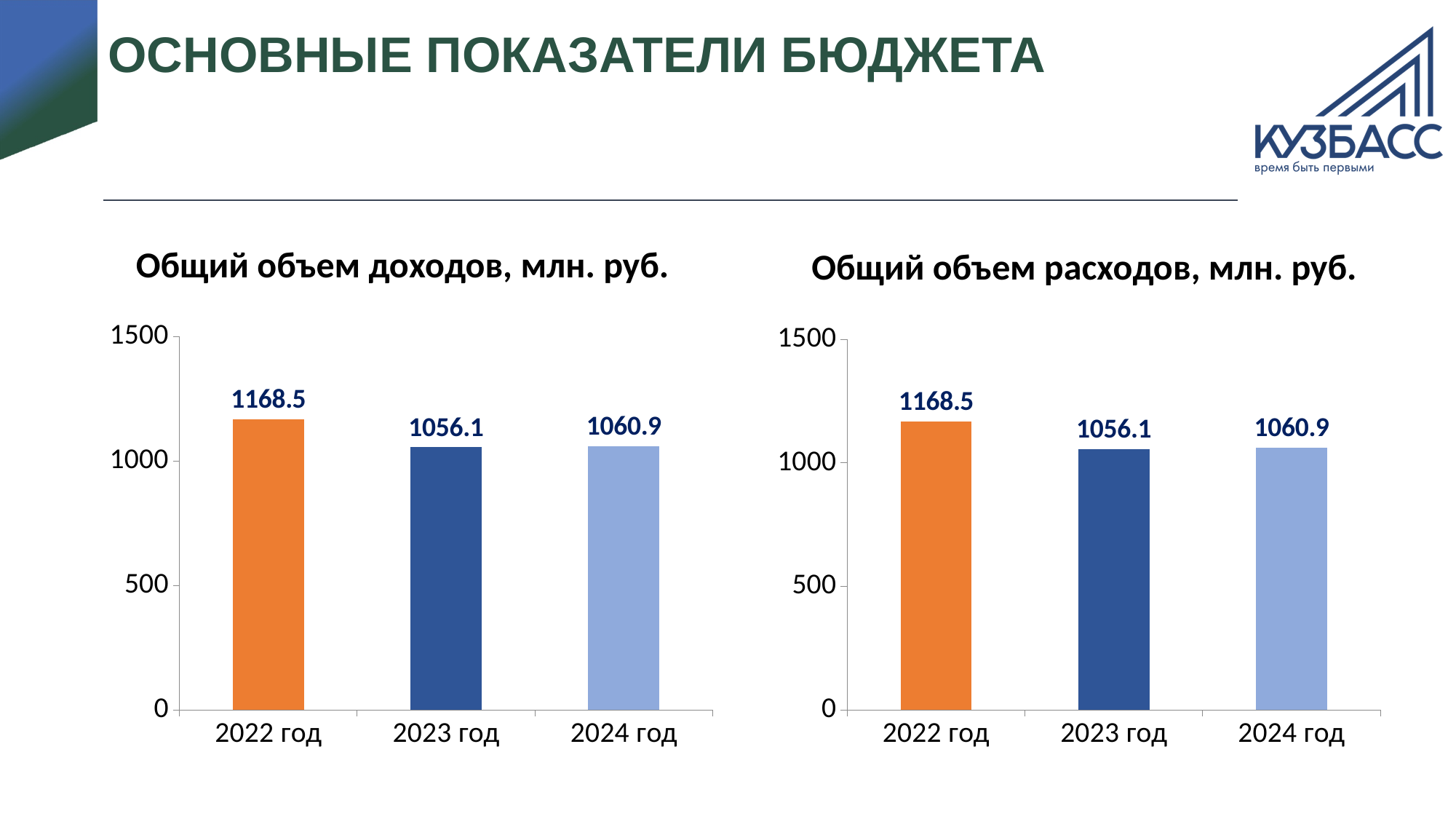
In the chart titled "Общий объем доходов, млн. руб.", what is the value for 2022 год? 1168.5 In the chart titled "Общий объем расходов, млн. руб.", what is the value for 2024 год? 1060.9 In the chart titled "Общий объем доходов, млн. руб.", what is the value for 2023 год? 1056.1 What is the title of the chart on the left side of the slide? Общий объем доходов, млн. руб. How many categories are shown on the x axis of the chart titled "Общий объем доходов, млн. руб."? 3 In the chart titled "Общий объем доходов, млн. руб.", which year has the lowest value? 2023 год In the chart titled "Общий объем доходов, млн. руб.", does the value rise or fall from 2022 год to 2023 год? fall In the chart titled "Общий объем расходов, млн. руб.", is the value for 2022 год greater or less than 1000? greater In the chart titled "Общий объем расходов, млн. руб.", what is the difference between the values for 2024 год and 2023 год? 4.8 In the chart titled "Общий объем расходов, млн. руб.", which year has the highest value? 2022 год In the chart titled "Общий объем доходов, млн. руб.", what is the difference between the values for 2022 год and 2023 год? 112.4 What kind of chart is the chart titled "Общий объем расходов, млн. руб."? bar chart